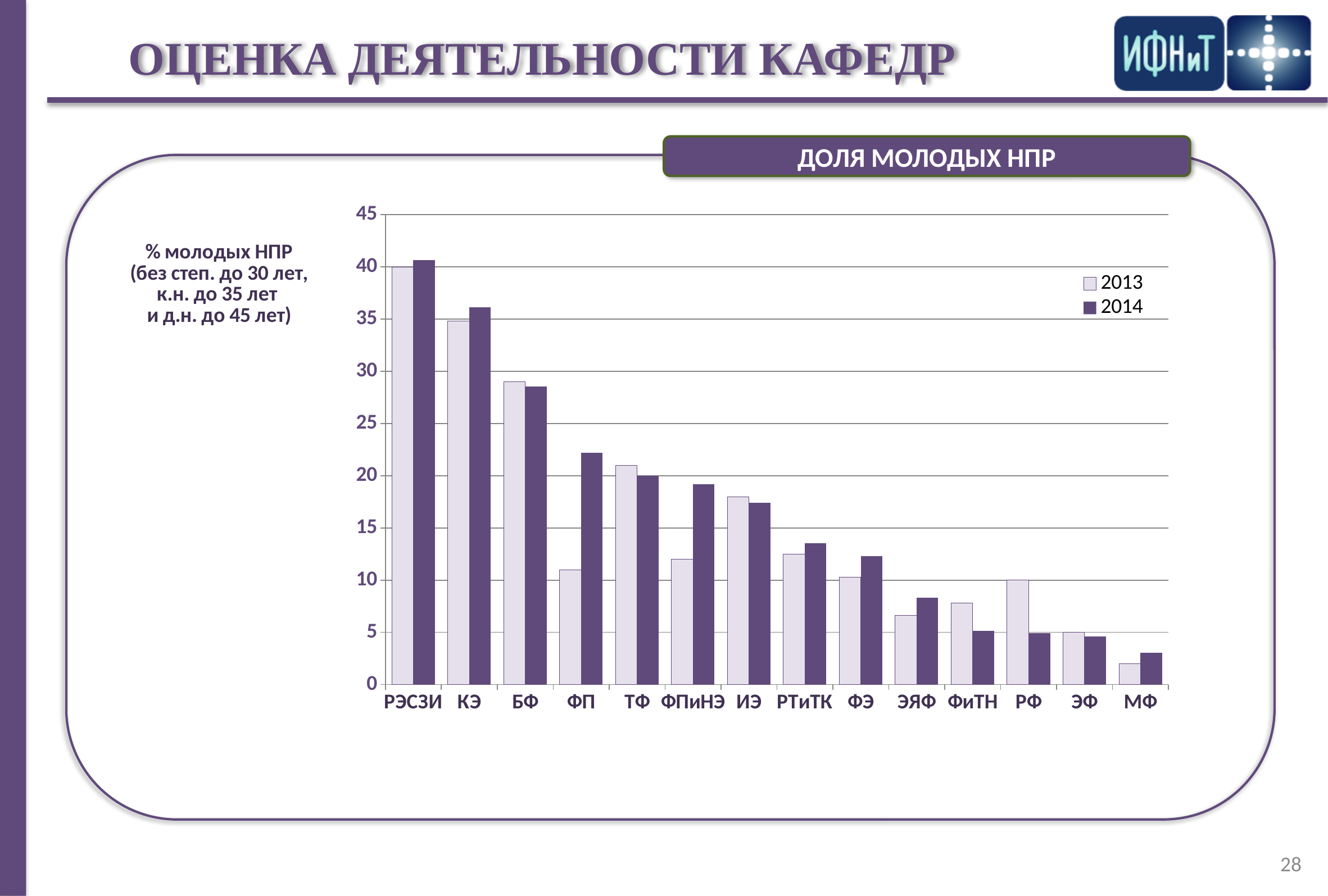
How many departments (categories) are shown on the x axis? 14 Which department has the lowest value for 2013? МФ Which is larger for ФПиНЭ: the 2013 value or the 2014 value? 2014 Is the value for КЭ in 2014 greater or less than 35? greater Which department has the highest value for 2014? РЭСЗИ Is the value for ФП in 2014 greater or less than 20? greater Which is larger for ФиТН: the 2013 value or the 2014 value? 2013 Is the value for ФП in 2013 greater or less than 15? less How many series does the legend list? 2 What is the title shown in the box above the chart? ДОЛЯ МОЛОДЫХ НПР What kind of chart is shown on the slide? bar chart Do the 2013 values generally rise or fall from left to right along the x axis? fall